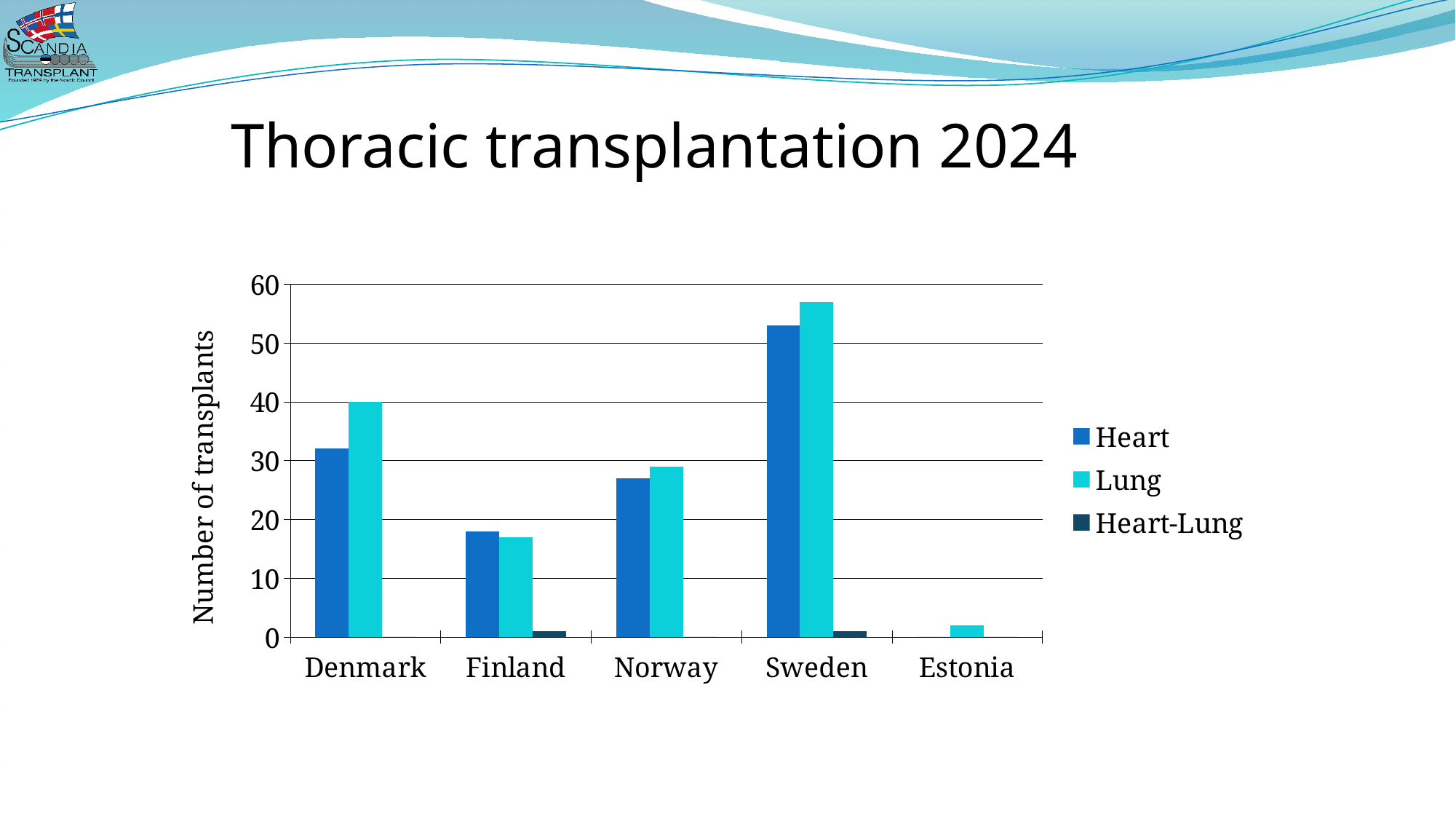
Which country has the highest number of Lung transplants? Sweden How many countries are shown on the x axis of the chart? 5 Which country has the lowest number of Lung transplants? Estonia Is the value for Heart transplants in Finland greater or less than 20? less Which country has the highest number of Heart transplants? Sweden Is the value for Heart transplants in Sweden greater or less than 50? greater What is the title of the chart on the slide? Thoracic transplantation 2024 How many series does the chart's legend list? 3 What is the label on the vertical axis of the chart? Number of transplants For Denmark, which is larger: Heart transplants or Lung transplants? Lung What is the number of Lung transplants for Denmark? 40 What kind of chart is shown on the slide? bar chart